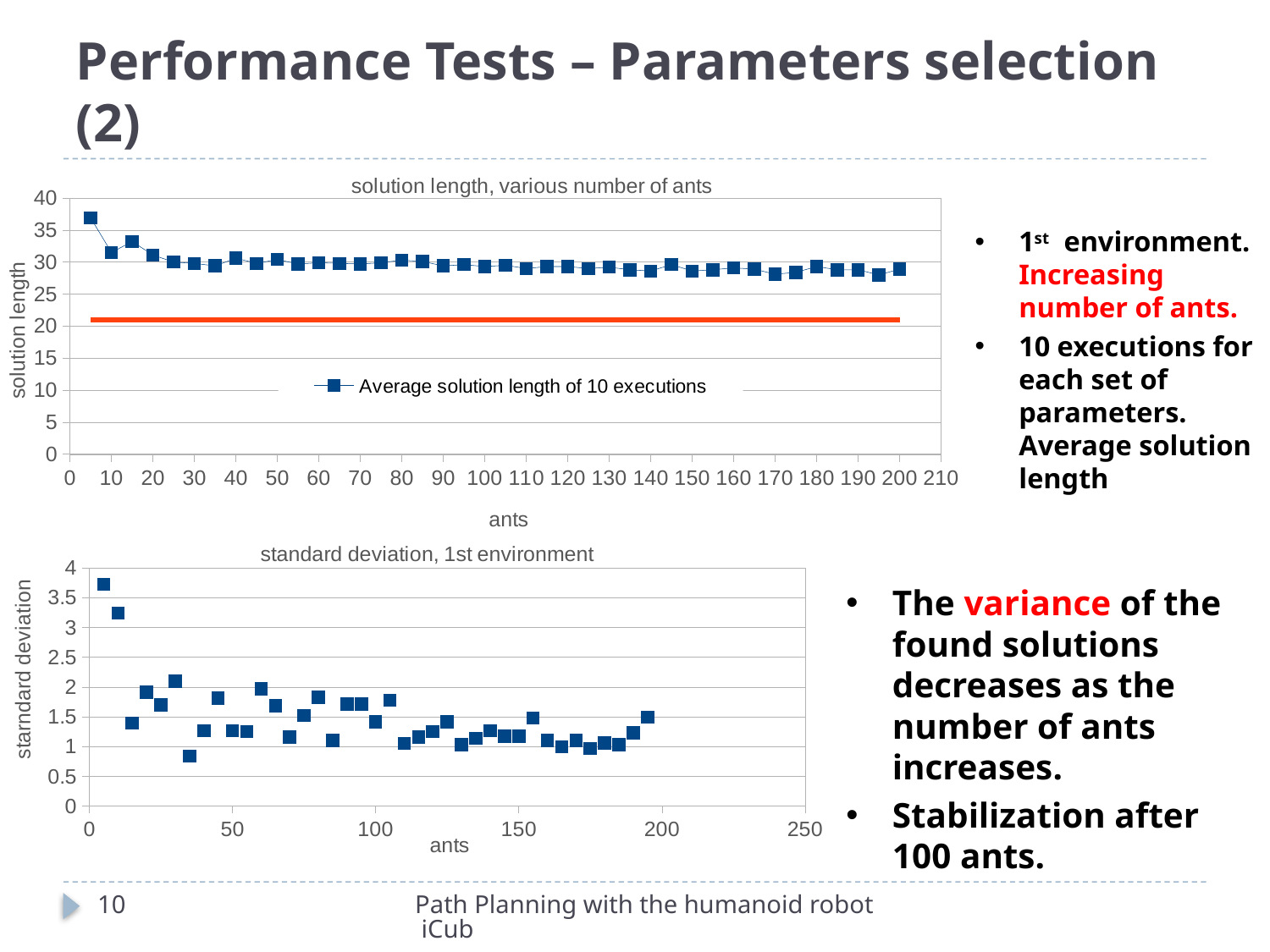
In the top chart 'solution length, various number of ants', what is the legend entry for the plotted series? Average solution length of 10 executions In the top chart 'solution length, various number of ants', how many series does the legend list? 1 In the bottom chart 'standard deviation, 1st environment', is the standard deviation at 5 ants greater or less than 3.5? greater What kind of chart is the bottom chart titled 'standard deviation, 1st environment'? scatter chart In the bottom chart 'standard deviation, 1st environment', at which number of ants is the standard deviation highest? 5 In the top chart 'solution length, various number of ants', do the solution length values generally rise or fall as the number of ants increases? fall In the top chart 'solution length, various number of ants', at which number of ants is the average solution length highest? 5 In the bottom chart 'standard deviation, 1st environment', is the standard deviation at 35 ants greater or less than 1? less What kind of chart is the top chart titled 'solution length, various number of ants'? line chart In the top chart 'solution length, various number of ants', is the solution length at 5 ants greater or less than 35? greater In the bottom chart 'standard deviation, 1st environment', what is the label on the x axis? ants